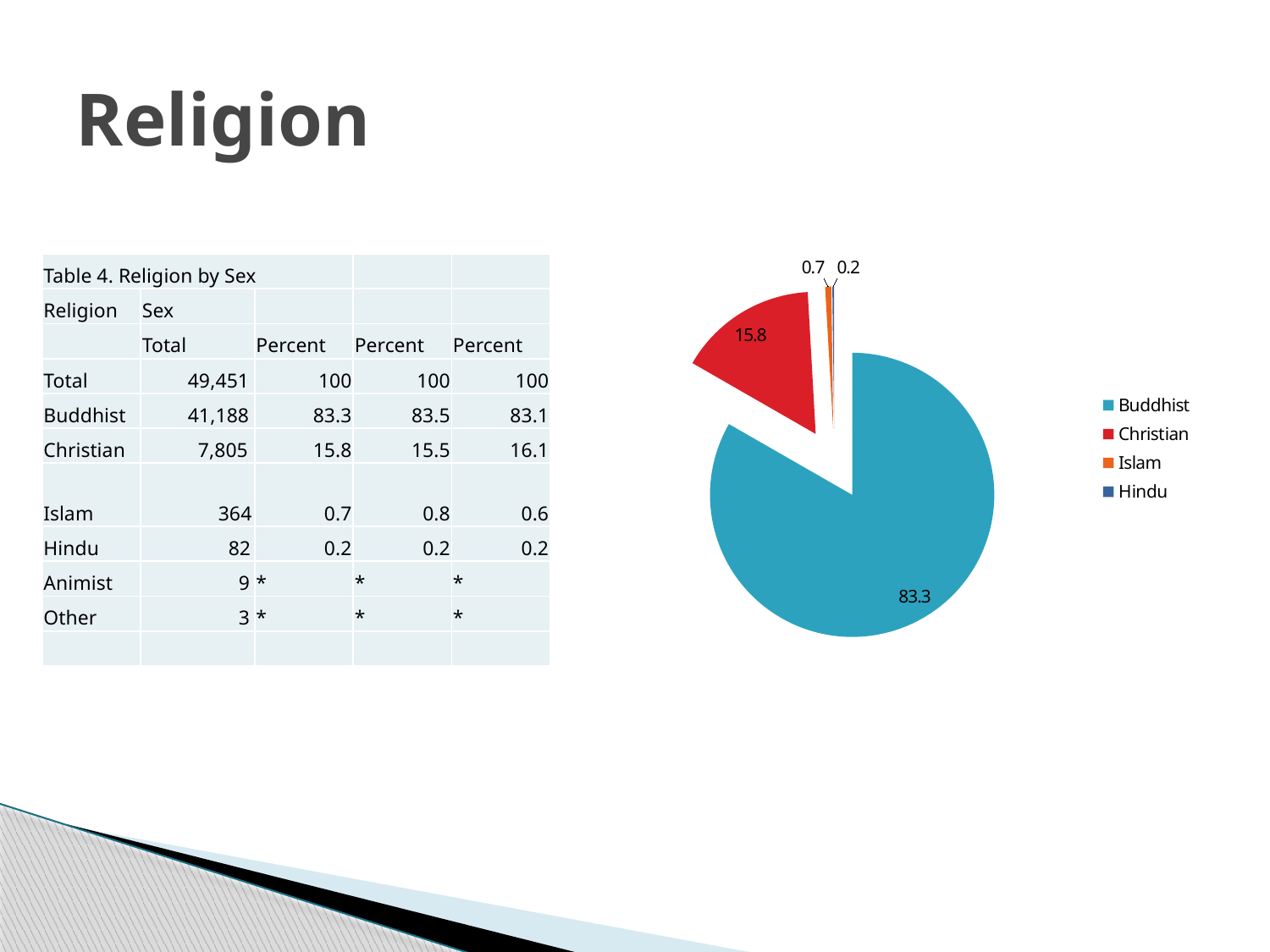
Which is larger in the pie chart, the Islam slice or the Hindu slice? Islam What colour is the Christian slice in the pie chart? red Which category has the smallest slice in the pie chart? Hindu How many slices does the pie chart have? 4 What is the value of the Christian slice in the pie chart? 15.8 Which category has the largest slice in the pie chart? Buddhist What is the value of the Hindu slice in the pie chart? 0.2 What kind of chart is shown on the slide? pie chart What is the difference between the Buddhist and Christian values in the pie chart? 67.5 What is the value of the Buddhist slice in the pie chart? 83.3 How many entries does the pie chart's legend list? 4 What is the value of the Islam slice in the pie chart? 0.7